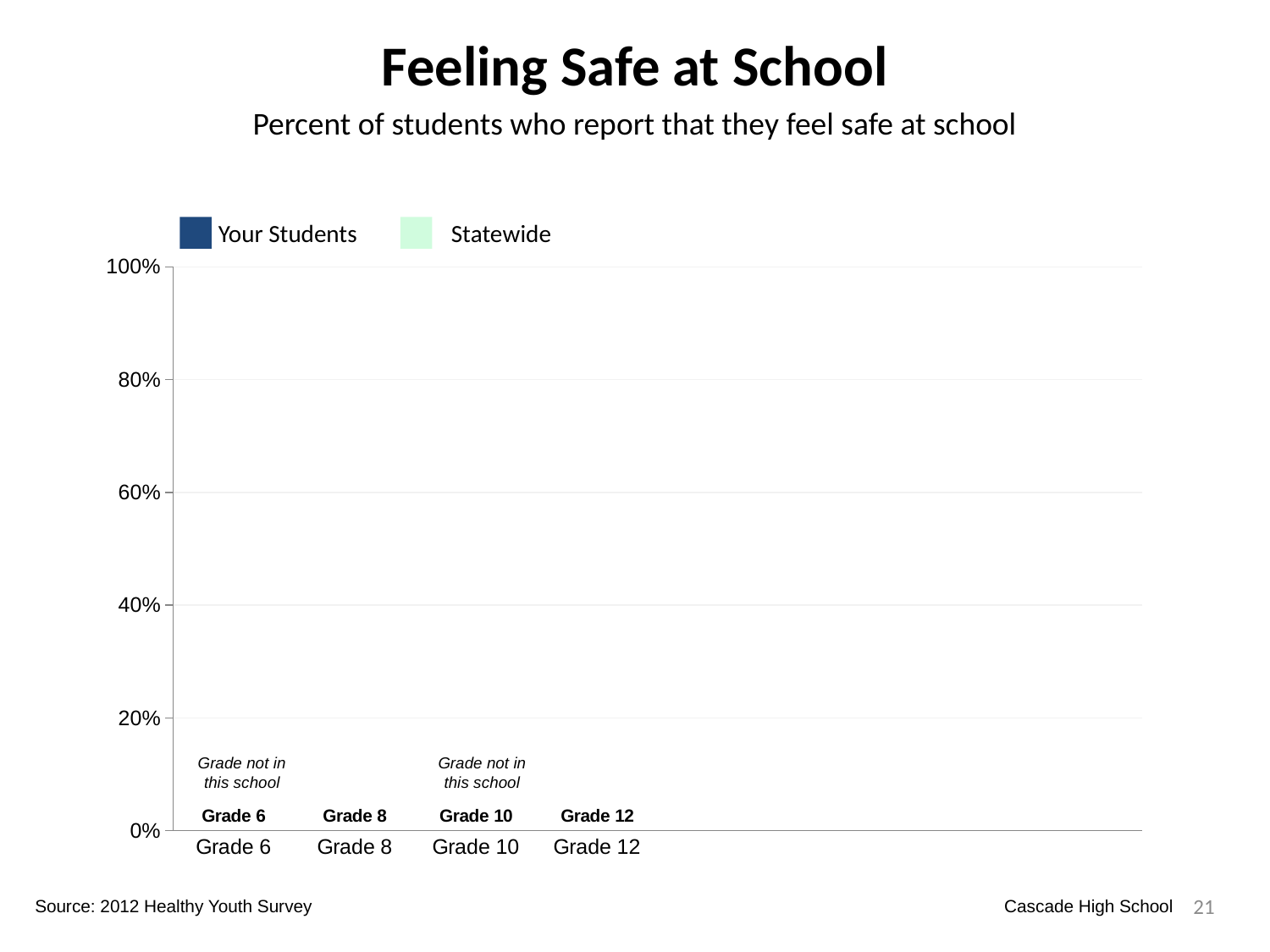
What is the highest value shown on the chart's y axis? 100% What is the source cited for the chart's data? 2012 Healthy Youth Survey How many grade categories are shown on the x axis of the chart? 4 What is the title of the chart? Feeling Safe at School Which grades are marked as 'Grade not in this school' on the chart? Grade 6 and Grade 10 Which school does the chart report on? Cascade High School How many series does the chart's legend list? 2 What are the two series named in the chart's legend? Your Students and Statewide